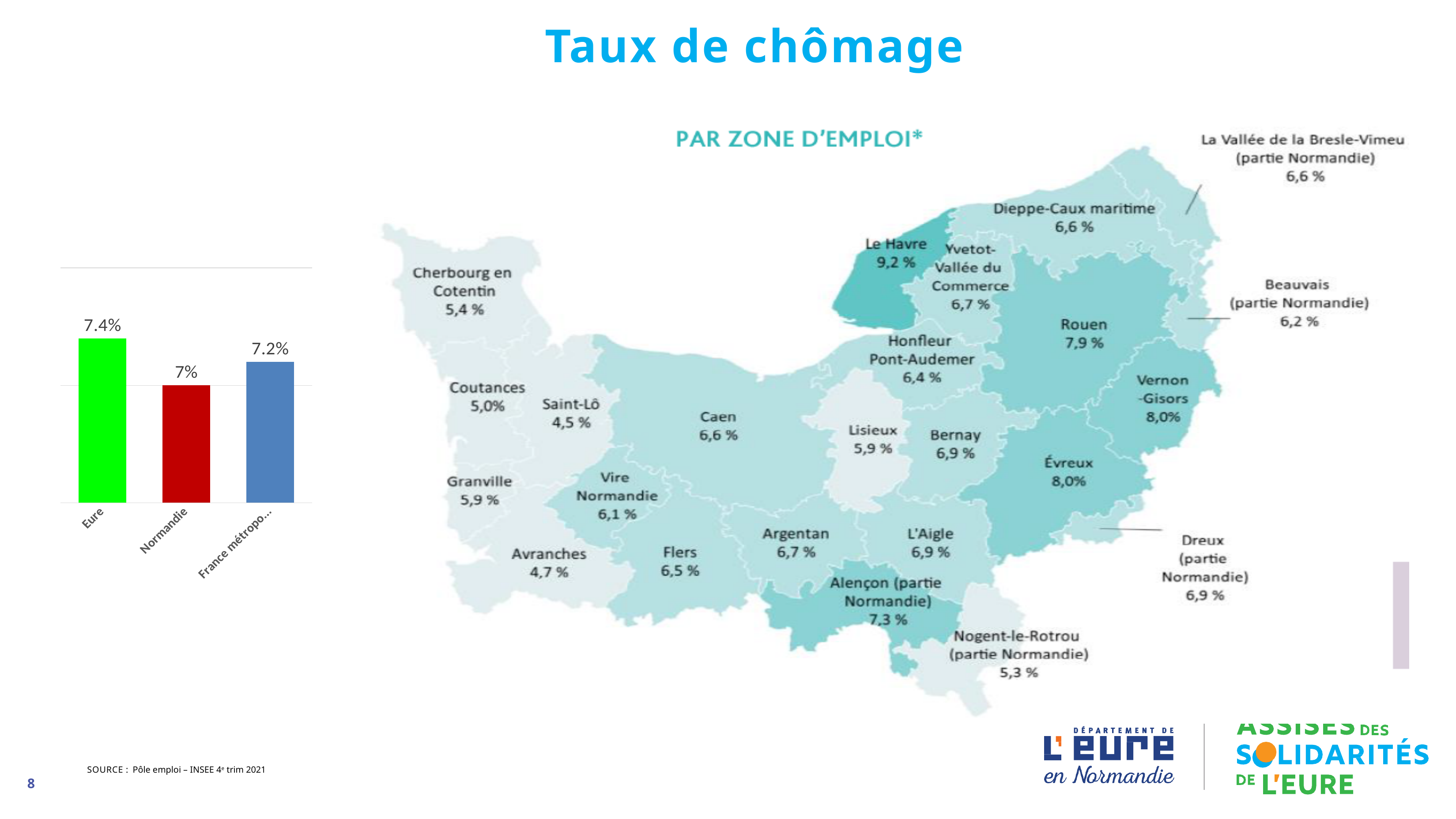
How many bars are shown in the bar chart on the left? 3 In the bar chart on the left, which is larger: the value for Normandie or the value for "France métropo..."? France métropo... In the bar chart on the left, what is the difference between the values for Eure and Normandie? 0.4% In the bar chart on the left, which category has the highest value? Eure In the bar chart on the left, which category has the lowest value? Normandie In the bar chart on the left, what colour is the bar for Eure? green What kind of chart is shown on the left of the slide? bar chart In the bar chart on the left, what is the value for the third bar, labelled "France métropo..."? 7.2% On the map "PAR ZONE D'EMPLOI*", which zone shows the lowest rate? Saint-Lô On the map "PAR ZONE D'EMPLOI*", what is the unemployment rate shown for Le Havre? 9,2 % In the bar chart on the left, what is the value for Eure? 7.4% In the bar chart on the left, what is the value for Normandie? 7%